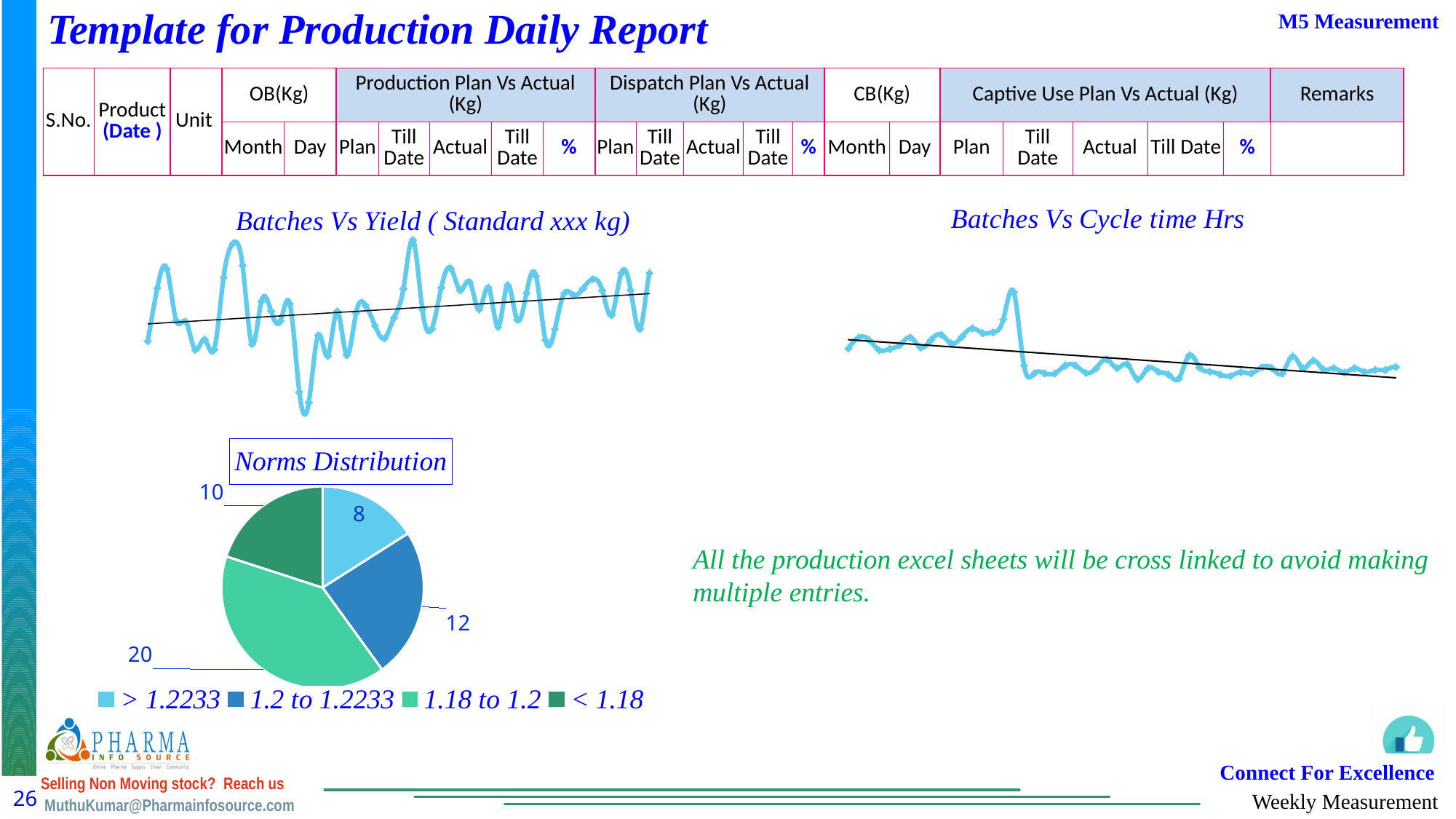
In the Norms Distribution chart, which category has the smallest slice? > 1.2233 In the "Batches Vs Cycle time Hrs" chart, does the trend line rise or fall from left to right? Fall What kind of chart is the Norms Distribution chart? Pie chart What kind of chart is the "Batches Vs Yield ( Standard xxx kg)" chart? Line chart In the Norms Distribution chart, what is the value for the "< 1.18" slice? 10 In the Norms Distribution chart, what is the value for the "> 1.2233" slice? 8 In the Norms Distribution chart, what is the difference between the "1.18 to 1.2" value and the "1.2 to 1.2233" value? 8 In the Norms Distribution chart, what is the value for the "1.18 to 1.2" slice? 20 In the Norms Distribution chart, what share of the total does the "1.18 to 1.2" slice represent? 40% In the Norms Distribution chart, which is larger: the "1.2 to 1.2233" slice or the "< 1.18" slice? 1.2 to 1.2233 In the Norms Distribution chart, which category has the largest slice? 1.18 to 1.2 How many categories does the legend of the Norms Distribution chart list? 4